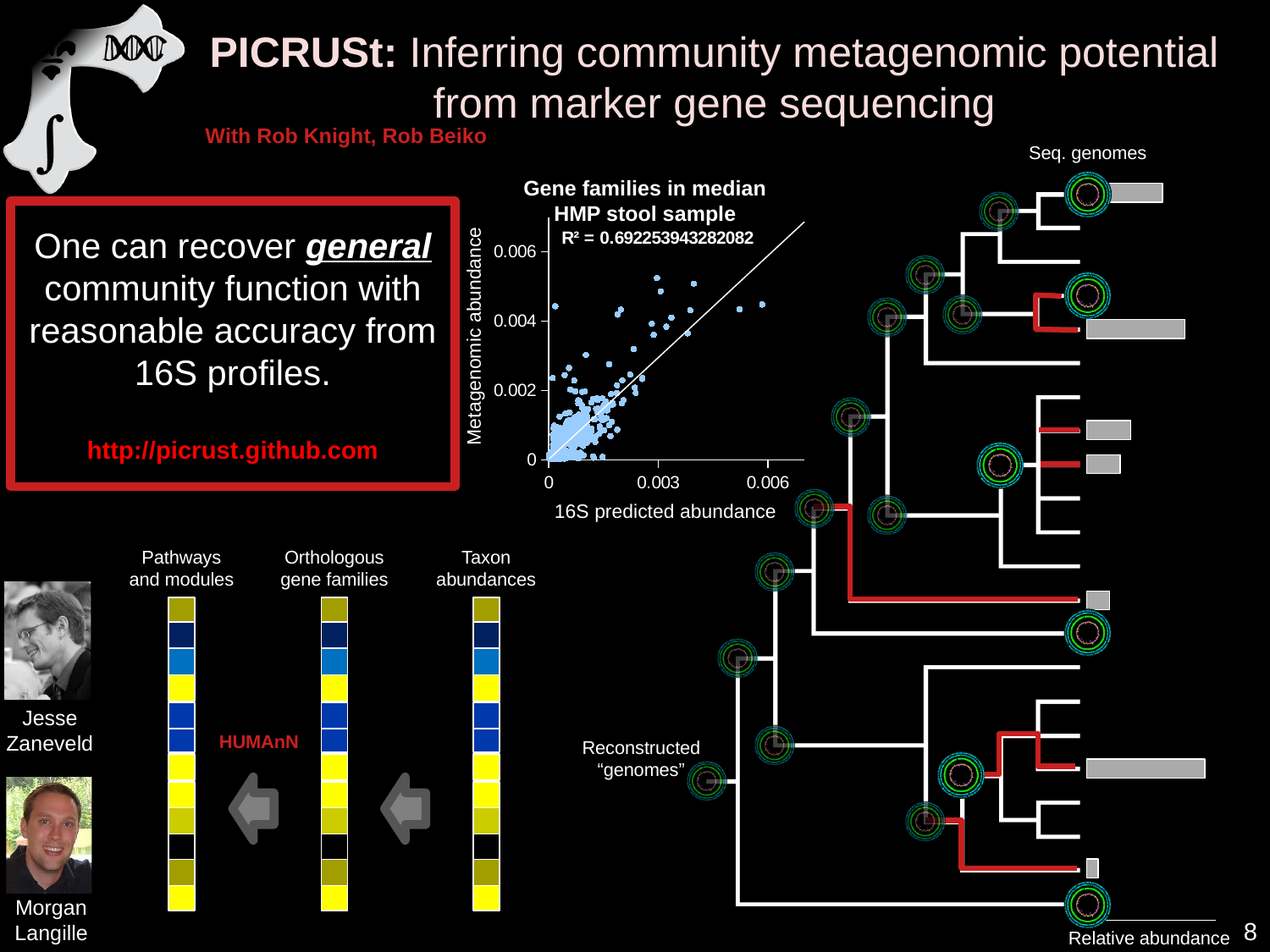
On the 'Gene families in median HMP stool sample' chart, what is the highest tick value shown on the x axis? 0.006 What R² value is printed on the 'Gene families in median HMP stool sample' chart? R² = 0.692253943282082 What is the label of the y axis on the 'Gene families in median HMP stool sample' chart? Metagenomic abundance How many tick labels are shown on the x axis of the 'Gene families in median HMP stool sample' chart? 3 What is the label of the x axis on the 'Gene families in median HMP stool sample' chart? 16S predicted abundance How many tick labels are shown on the y axis of the 'Gene families in median HMP stool sample' chart? 4 On the 'Gene families in median HMP stool sample' chart, does metagenomic abundance generally rise or fall as 16S predicted abundance increases? rise On the 'Gene families in median HMP stool sample' chart, what is the highest tick value shown on the y axis? 0.006 What is the title of the scatter chart on the slide? Gene families in median HMP stool sample Is the R² value printed on the 'Gene families in median HMP stool sample' chart greater or less than 0.5? greater What kind of chart is the 'Gene families in median HMP stool sample' chart? scatter plot